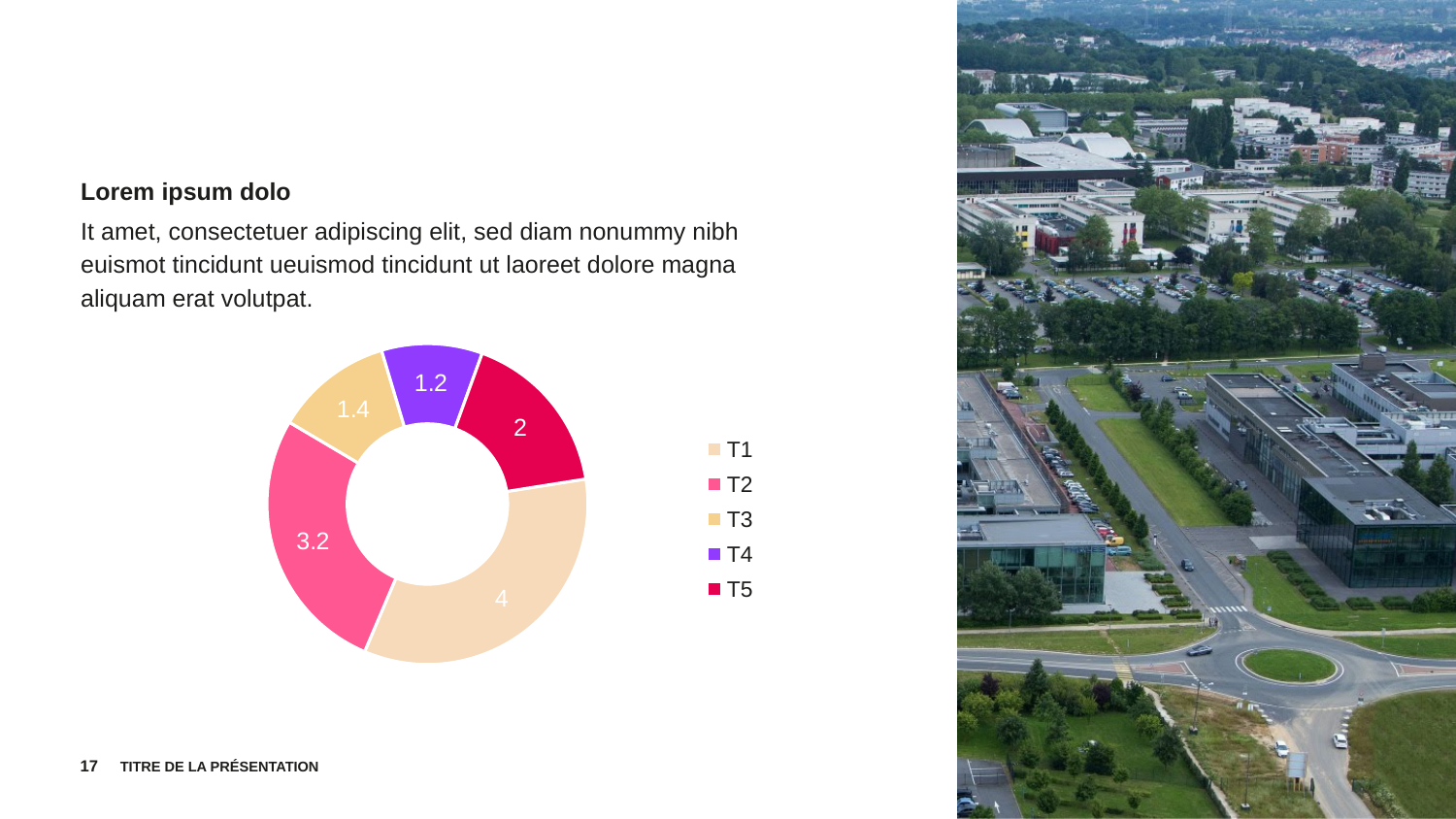
Which is larger, the value for T3 or the value for T5? T5 What is the difference between the values for T1 and T2? 0.8 What is the difference between the values for T5 and T3? 0.6 What is the value for T1 in the doughnut chart? 4 Which category has the smallest slice in the doughnut chart? T4 What is the value for T2 in the doughnut chart? 3.2 What is the value for T4 in the doughnut chart? 1.2 How many categories does the doughnut chart show? 5 Which category has the largest slice in the doughnut chart? T1 What kind of chart is shown on the slide? Doughnut chart What is the value for T5 in the doughnut chart? 2 What colour is the T4 slice in the doughnut chart? Purple